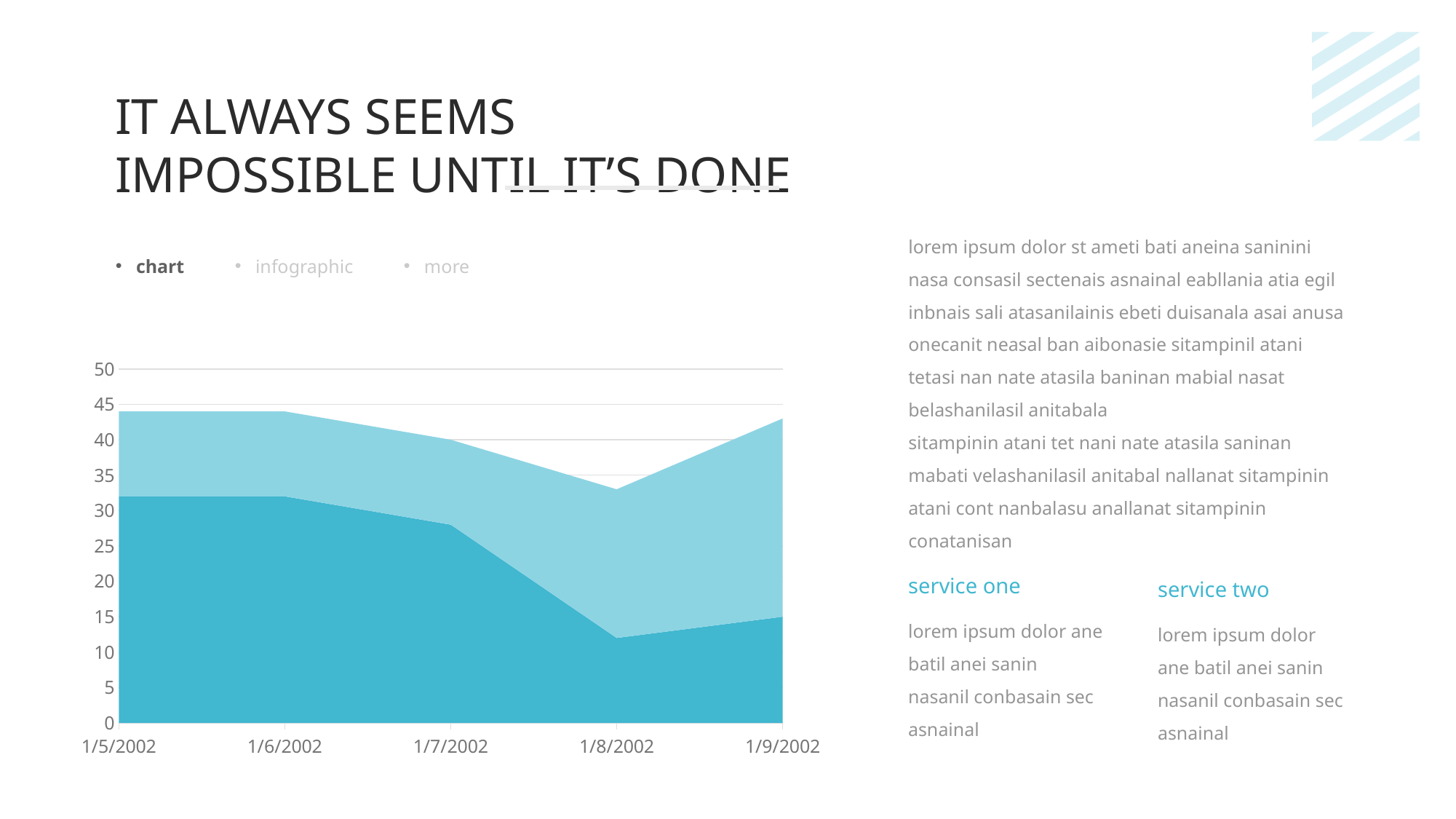
At which date does the bottom (darker) series reach its lowest value? 1/8/2002 What kind of chart is shown on the slide? Area chart How many shaded series are stacked in the chart? 2 At which date is the top of the stacked area lowest? 1/8/2002 How many dates are shown along the x axis of the chart? 5 Is the value of the bottom (darker) series at 1/8/2002 greater or less than 15? less Is the top of the stacked area at 1/5/2002 greater or less than 40? greater Is the value of the bottom (darker) series at 1/7/2002 greater or less than 30? less Does the bottom (darker) series rise or fall from 1/5/2002 to 1/8/2002? fall Is the bottom (darker) series larger at 1/5/2002 or at 1/8/2002? 1/5/2002